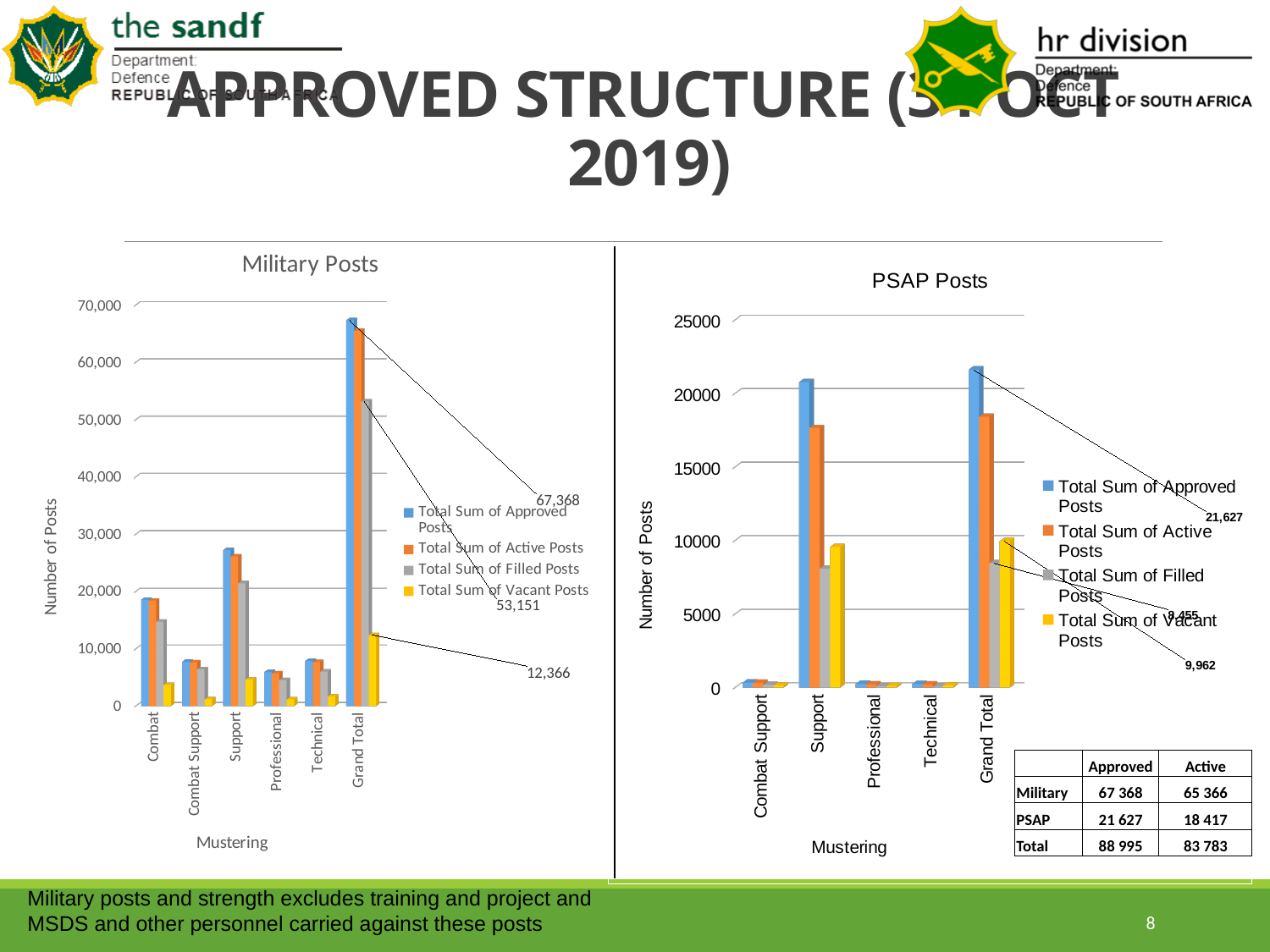
How many mustering categories are shown on the x axis of the Military Posts chart? 6 How many series does the legend of the Military Posts chart list? 4 In the PSAP Posts chart, is the Total Sum of Approved Posts for Support greater or less than 15000? greater What kind of chart is the Military Posts chart? bar chart In the Military Posts chart, what is the Total Sum of Filled Posts for Grand Total? 53,151 In the Military Posts chart, is the Total Sum of Approved Posts for Support greater or less than 20,000? greater In the Military Posts chart, what is the difference between the Grand Total Approved Posts and the Grand Total Filled Posts? 14,217 In the PSAP Posts chart, what is the Total Sum of Approved Posts for Grand Total? 21,627 In the Military Posts chart, which has more Approved Posts: Combat or Support? Support In the Military Posts chart, what is the Total Sum of Vacant Posts for Grand Total? 12,366 In the PSAP Posts chart, what is the Total Sum of Vacant Posts for Grand Total? 9,962 In the Military Posts chart, what is the Total Sum of Approved Posts for Grand Total? 67,368